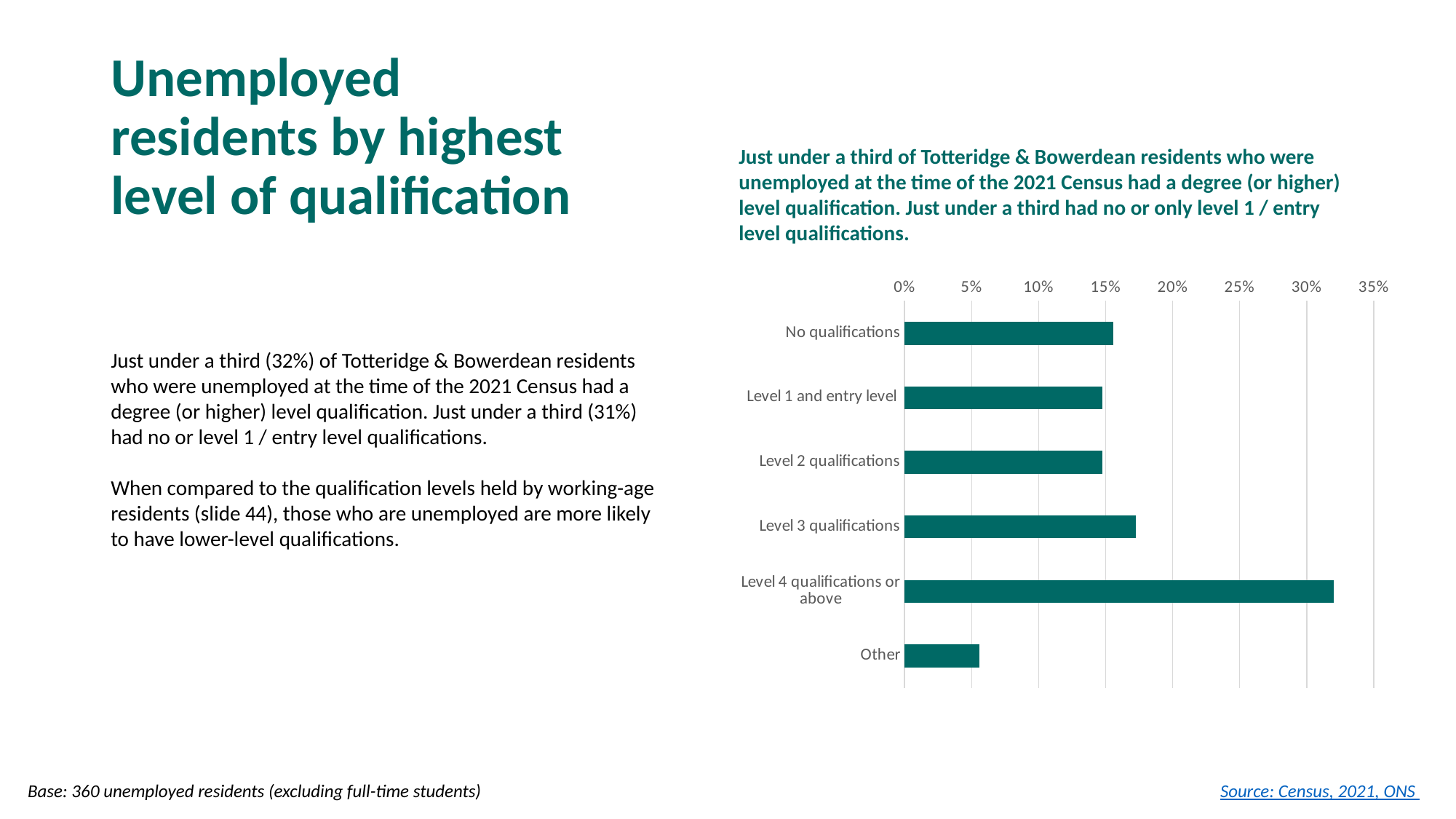
Is the value for Level 4 qualifications or above greater or less than 30%? greater Is the value for Level 2 qualifications greater or less than 20%? less What kind of chart is shown on the slide? Bar chart What is the highest value shown on the chart's percentage axis? 35% Is the value for Level 3 qualifications greater or less than 15%? greater Which category has the lowest value in the chart? Other Which category has the highest value in the chart? Level 4 qualifications or above What is the base (number of residents) stated for the chart? 360 unemployed residents (excluding full-time students) Which is larger: the value for Level 4 qualifications or above or the value for No qualifications? Level 4 qualifications or above Which is larger: the value for Level 3 qualifications or the value for Level 2 qualifications? Level 3 qualifications How many qualification categories are plotted in the chart? 6